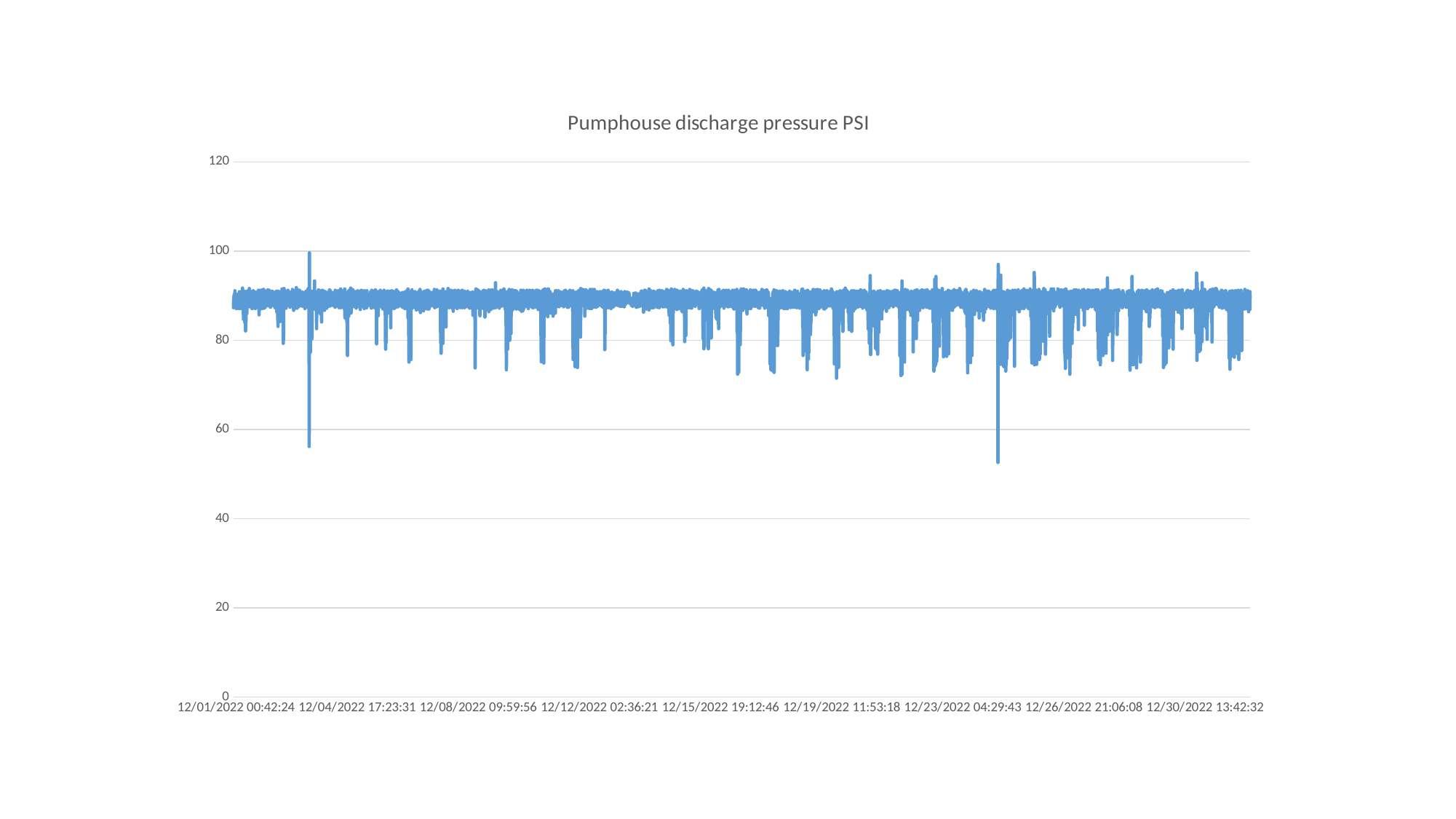
Is the lowest value reached by the line greater or less than 60? less What is the highest value shown on the vertical axis? 120 Overall, does the pressure level rise, fall, or stay roughly flat across the month? roughly flat What is the first date label on the horizontal axis? 12/01/2022 00:42:24 Is the value at the start of the series, around 12/01/2022, greater or less than 80? greater Is the typical level of the line greater or less than 100? less What kind of chart is shown on the slide? line chart What is the title of the chart? Pumphouse discharge pressure PSI How many date labels are shown along the horizontal axis? 9 Is the deepest dip in the line located near 12/04/2022 or near 12/23/2022? near 12/23/2022